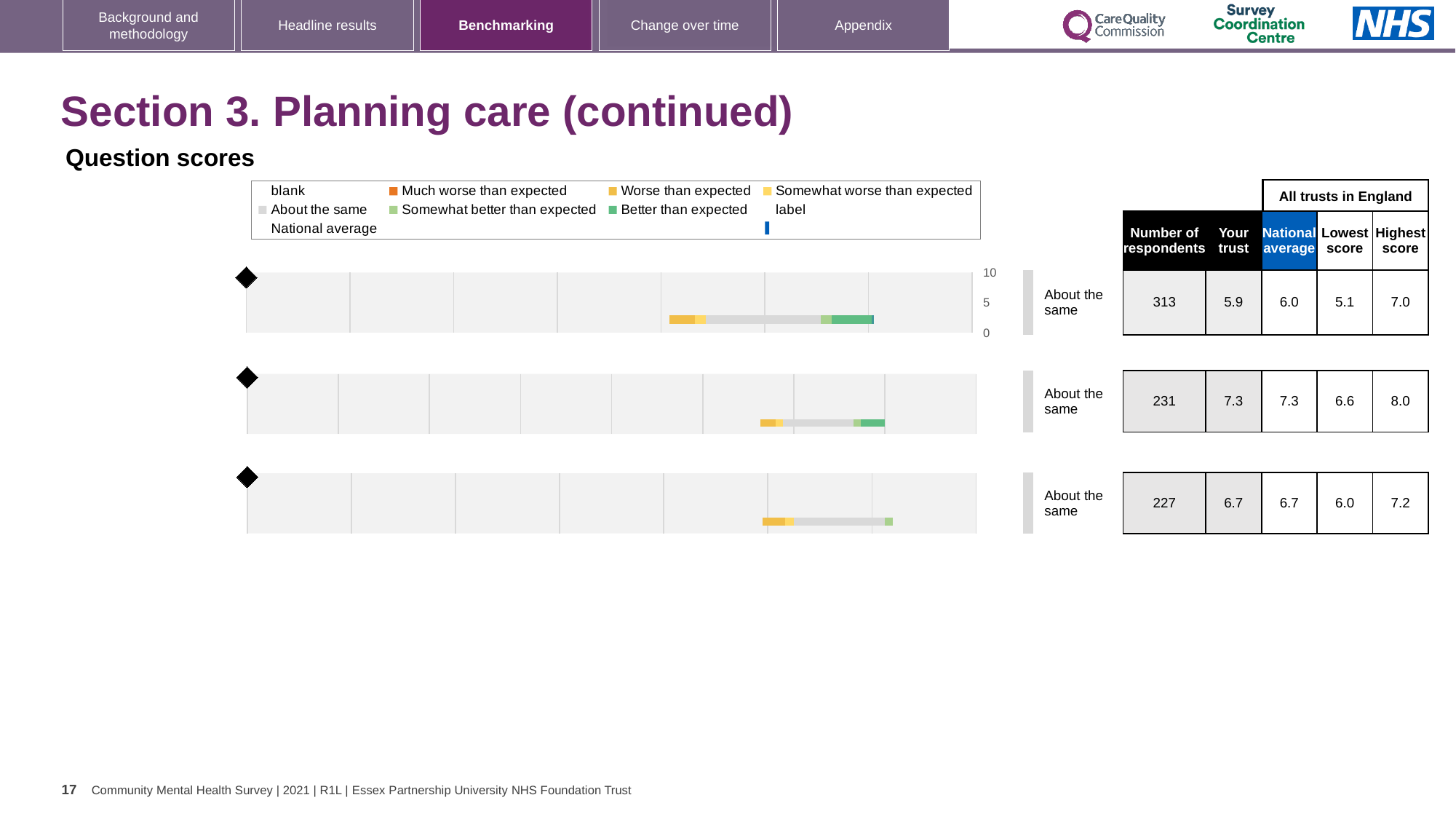
For the top chart, how many respondents are there? 313 For the top chart, what is the 'Your trust' score? 5.9 For the bottom chart, what is the lowest score among all trusts in England? 6.0 For the middle chart, what is the highest score among all trusts in England? 8.0 For the bottom chart, is the 'Your trust' score greater or less than 5? greater Which chart has the highest 'Your trust' score: top, middle or bottom? middle For the top chart, which is larger: the 'Your trust' score or the national average? National average How many question score charts are shown on the slide? 3 For the top chart, what is the difference between the highest score and the lowest score? 1.9 What kind of chart is used to show the question scores on this slide? bar chart What benchmark category is shown next to the top chart? About the same In the legend, what colour represents 'Much worse than expected'? orange